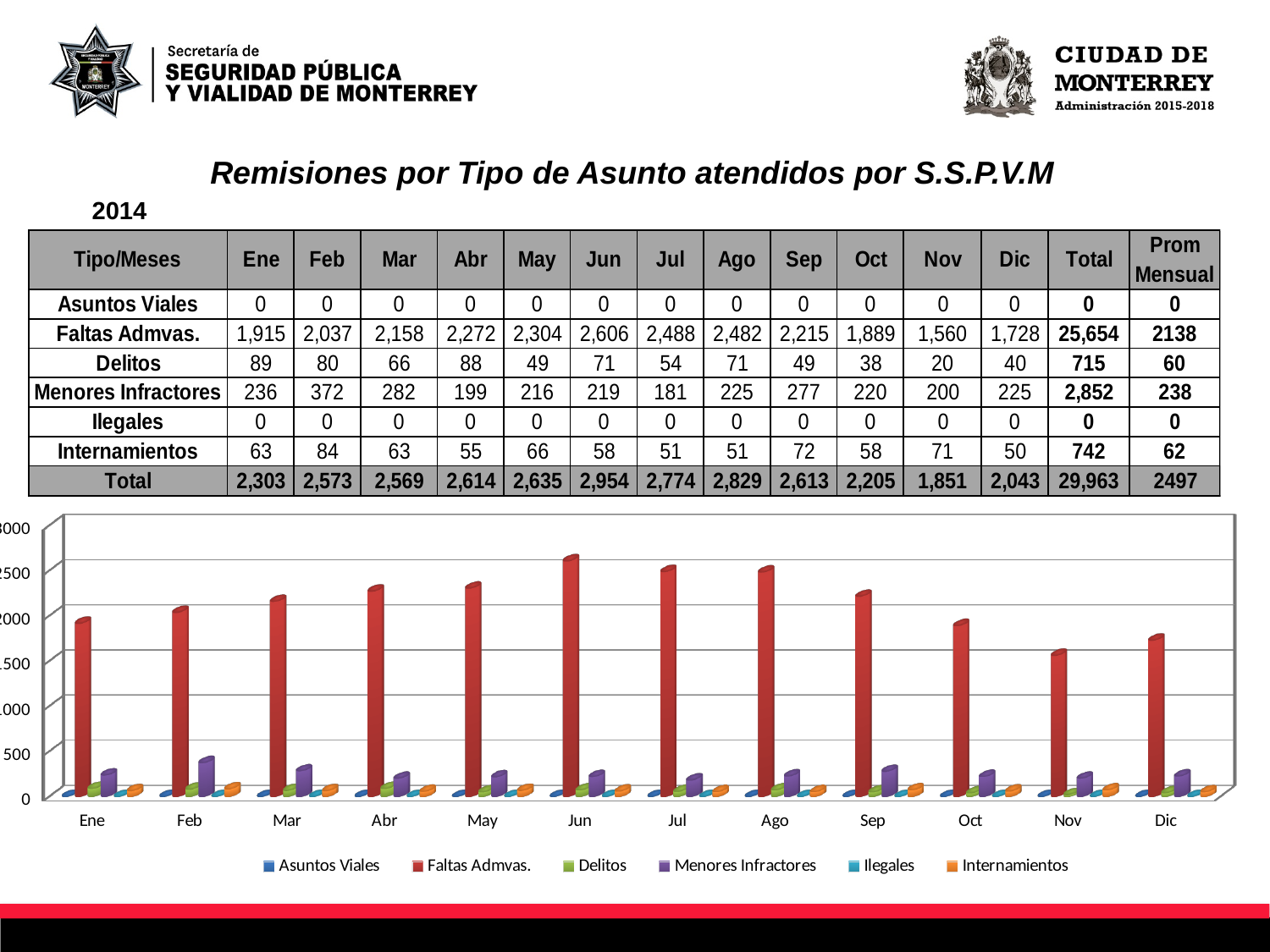
In which month is the Faltas Admvas. bar lowest? Nov Which is larger, the Faltas Admvas. value for Jun or for Nov? Jun How many months are shown along the x axis of the chart? 12 In which month is the Faltas Admvas. bar highest? Jun How many series does the chart's legend list? 6 Is the Faltas Admvas. value for Nov greater or less than 2000? less What is the value of Faltas Admvas. for Jun? 2,606 What is the value of Menores Infractores for Feb? 372 What is the difference between the Faltas Admvas. values for Jun and Nov? 1,046 What kind of chart is shown on the slide? bar chart Which colour represents Faltas Admvas. in the chart? red Is the Faltas Admvas. value for Jun greater or less than 2500? greater